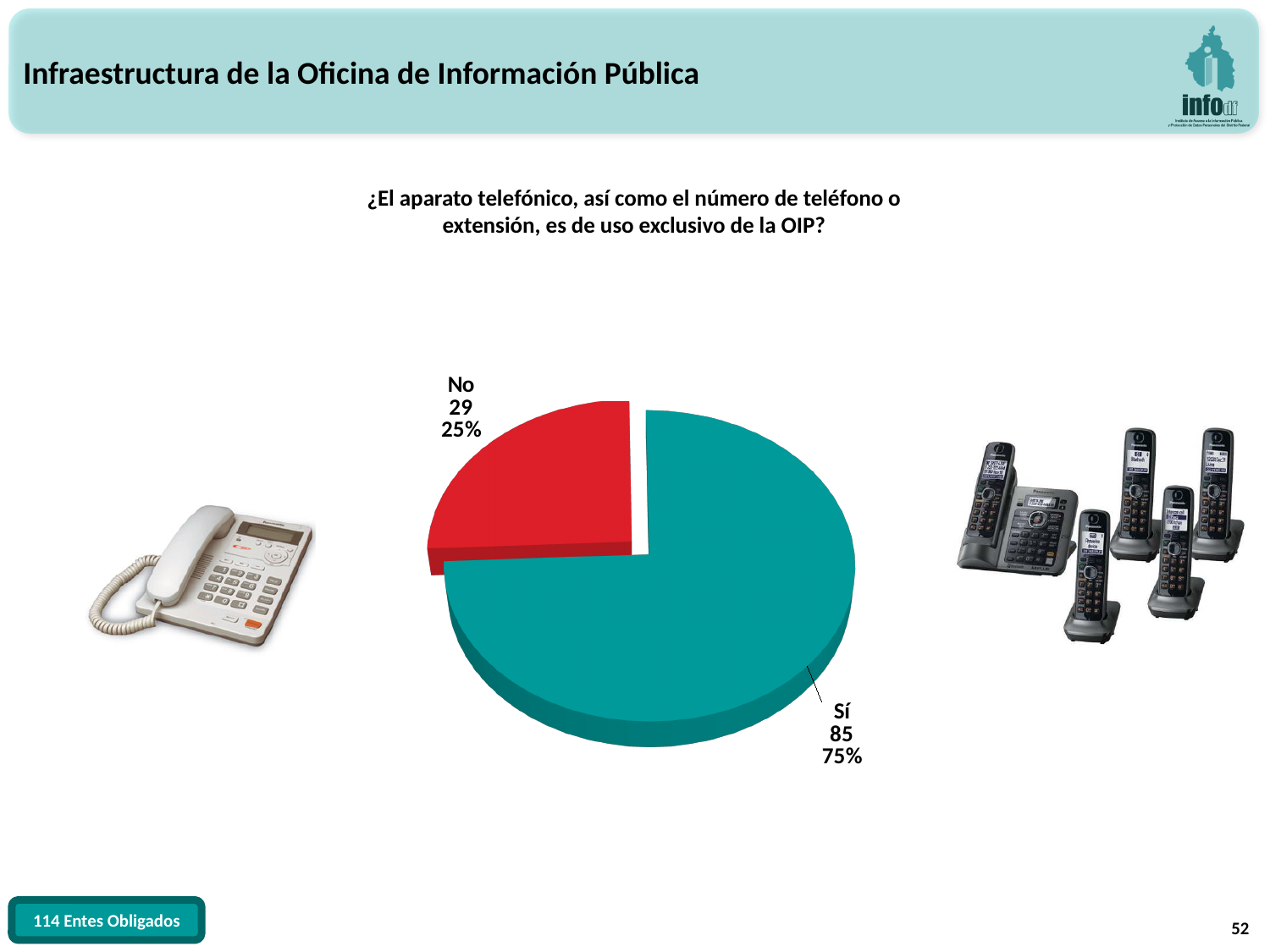
What is the value for the 'No' slice? 29 What colour is the 'No' slice? red What kind of chart is shown on the slide? pie chart Which slice is the smallest? No How many slices does the pie chart have? 2 Which is larger, the value for 'Sí' or the value for 'No'? Sí What is the value for the 'Sí' slice? 85 What is the total of the two slices in the pie chart? 114 What share of the pie does the 'No' slice represent? 25% Which slice is the largest? Sí What is the difference between the 'Sí' and 'No' values? 56 What share of the pie does the 'Sí' slice represent? 75%